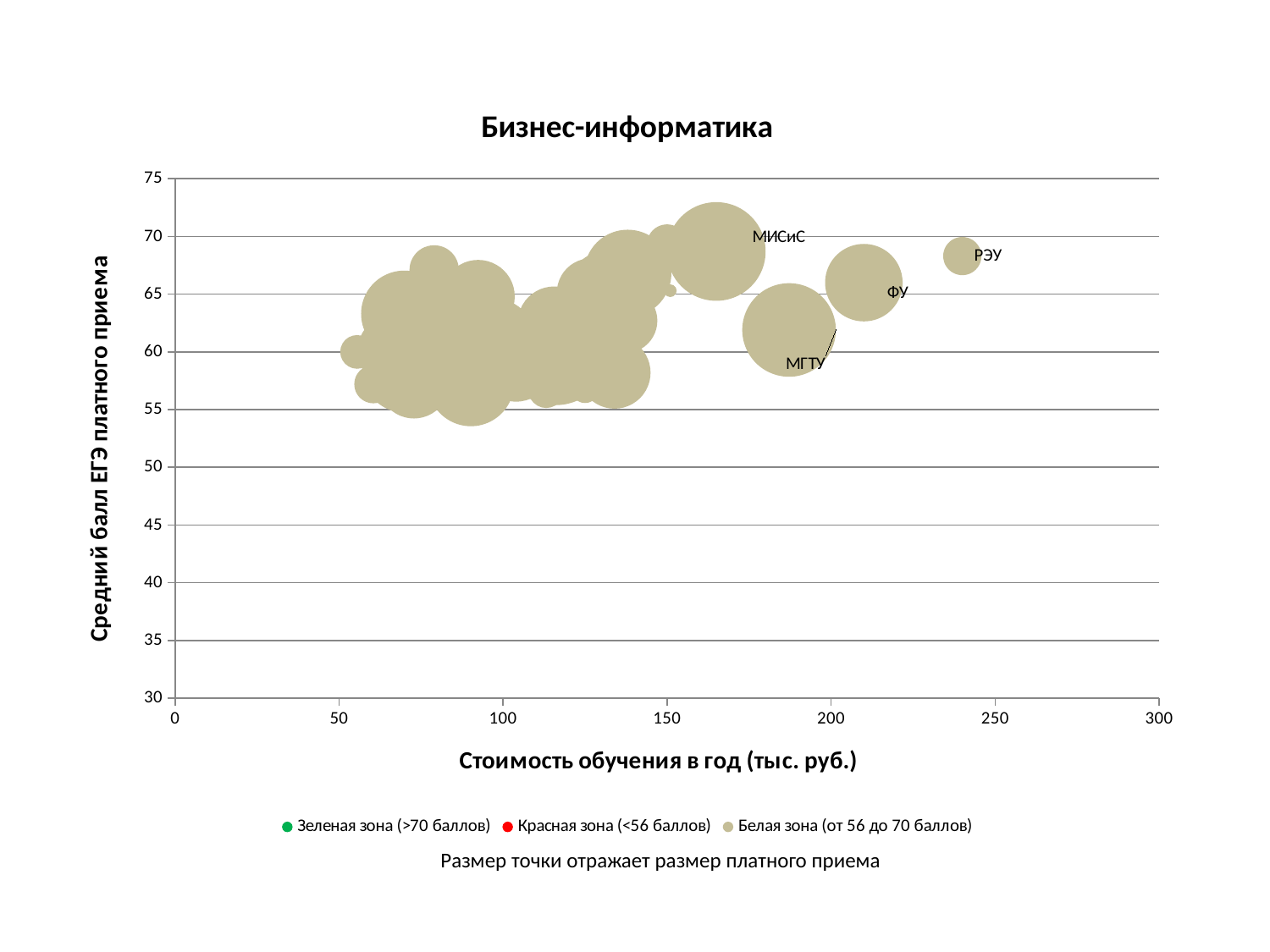
Is the average score (y axis) for МИСиС greater or less than 65? greater Among the labeled universities, which has the lowest average score? МГТУ Which has the higher average score, МИСиС or МГТУ? МИСиС Is the tuition cost (x axis) for ФУ greater or less than 200? greater What kind of chart is shown on the slide? Bubble chart Is the average score (y axis) for МГТУ greater or less than 65? less How many series does the legend list? 3 What is the title of the chart? Бизнес-информатика Among the labeled universities, which has the highest tuition cost? РЭУ According to the note under the chart, what does the size of a point reflect? Размер платного приема Which has the higher tuition cost, РЭУ or МГТУ? РЭУ